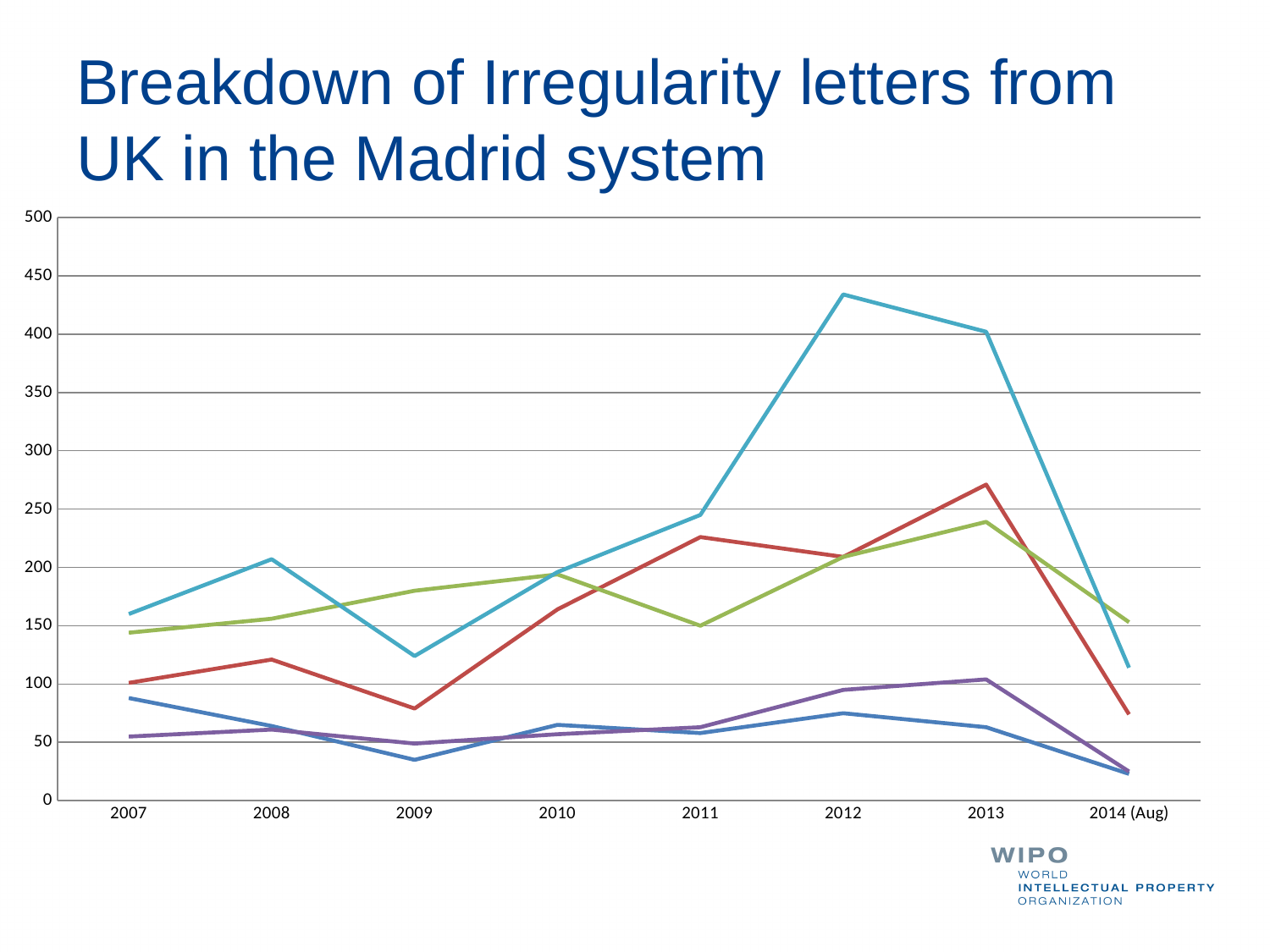
Is the value of the light blue line in 2012 greater or less than 400? greater How many time points are shown along the x axis of the chart? 8 What kind of chart is shown on the slide? line chart In which year does the light blue line reach its highest value? 2012 What is the first year shown on the x axis? 2007 Is the value of the dark blue line in 2009 greater or less than 50? less How many lines are plotted on the chart? 5 Is the value of the red line in 2013 greater or less than 250? greater What is the title of the chart on the slide? Breakdown of Irregularity letters from UK in the Madrid system Does the light blue line rise or fall between 2013 and 2014 (Aug)? fall